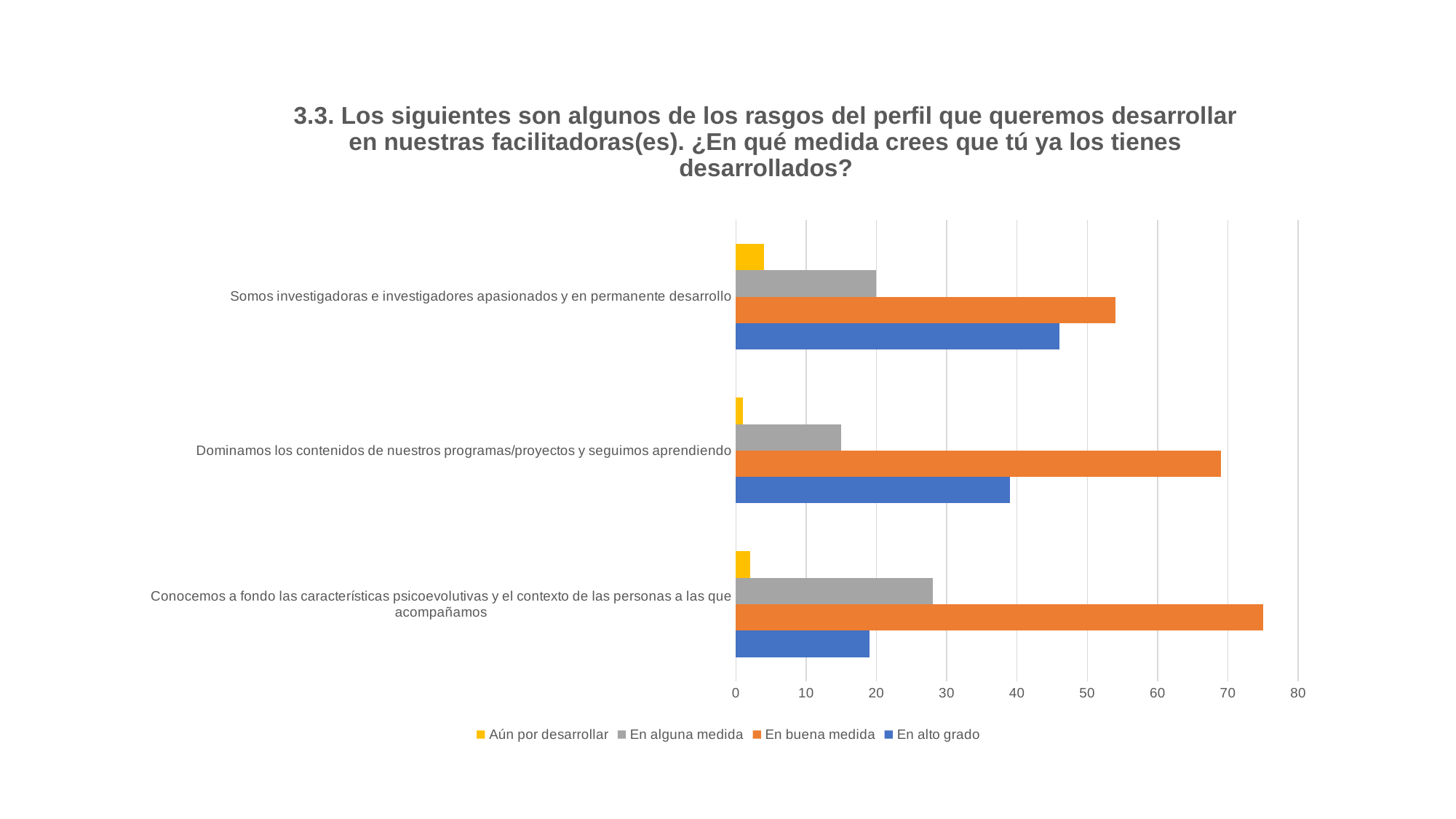
Which category has the highest value for 'En buena medida'? Conocemos a fondo las características psicoevolutivas y el contexto de las personas a las que acompañamos How many categories (profile traits) are plotted on the chart? 3 What kind of chart is shown on the slide? bar chart Is the value of 'En buena medida' for 'Conocemos a fondo las características psicoevolutivas y el contexto de las personas a las que acompañamos' greater or less than 70? greater Which category has the lowest value for 'En alto grado'? Conocemos a fondo las características psicoevolutivas y el contexto de las personas a las que acompañamos Which colour represents the 'En buena medida' series in the legend? orange For 'Somos investigadoras e investigadores apasionados y en permanente desarrollo', which is larger: 'En buena medida' or 'En alto grado'? En buena medida Is the value of 'En alto grado' for 'Conocemos a fondo las características psicoevolutivas y el contexto de las personas a las que acompañamos' greater or less than 30? less How many series does the legend list? 4 Is the value of 'En buena medida' for 'Dominamos los contenidos de nuestros programas/proyectos y seguimos aprendiendo' greater or less than 60? greater Which category has the highest value for 'En alto grado'? Somos investigadoras e investigadores apasionados y en permanente desarrollo